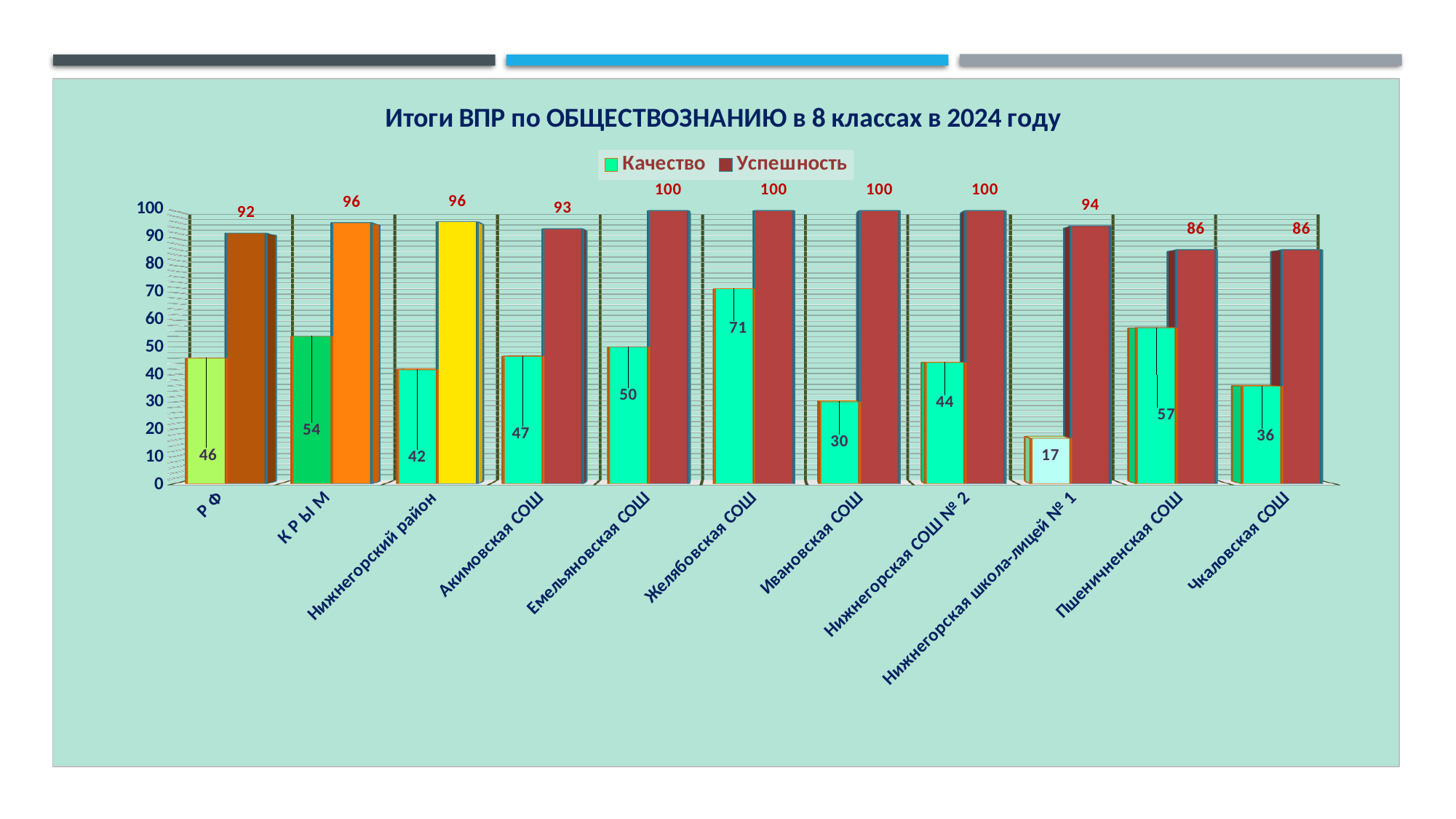
What is the Успешность value for Акимовская СОШ? 93 How many categories are shown on the x axis? 11 Which category has the highest Качество value? Желябовская СОШ What is the Качество value for Желябовская СОШ? 71 What is the Качество value for Нижнегорская школа-лицей № 1? 17 How many series does the legend list? 2 What kind of chart is shown on the slide? bar chart Which is larger, the Качество value for КРЫМ or the Качество value for Пшениченская СОШ? Пшеничненская СОШ What is the difference between the Успешность and Качество values for Ивановская СОШ? 70 Is the Качество value for Чкаловская СОШ greater or less than 40? less Which category has the lowest Качество value? Нижнегорская школа-лицей № 1 What is the title of the chart? Итоги ВПР по ОБЩЕСТВОЗНАНИЮ в 8 классах в 2024 году